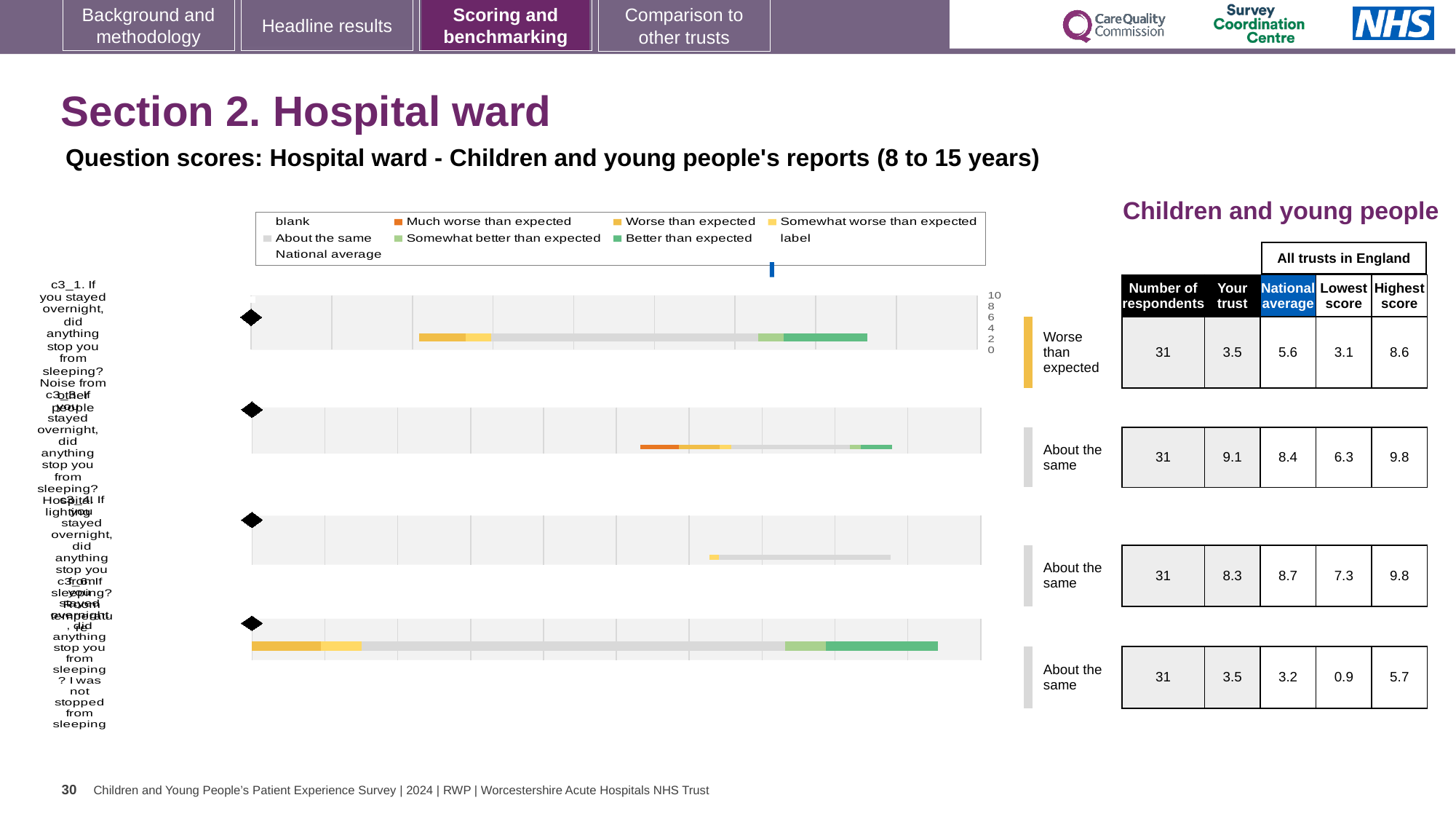
What colour does the legend use for 'Much worse than expected'? orange In the table beside the chart, what is the difference between the Highest score and Lowest score in the top row? 5.5 How many entries does the chart legend list? 9 In the table beside the chart, what is the Highest score for the bottom row? 5.7 What colour does the legend use for 'Better than expected'? green In the table beside the chart, how many respondents are listed for each row? 31 How many horizontal bars are plotted in the chart? 4 In the table beside the chart, what is the Lowest score for the third row? 7.3 What kind of chart is shown on the slide? bar chart In the table beside the chart, which row has the highest 'Your trust' score? the second row (9.1) In the table beside the chart, what is the National average for the second row? 8.4 In the table beside the chart, what is the 'Your trust' score for the top row (Worse than expected)? 3.5